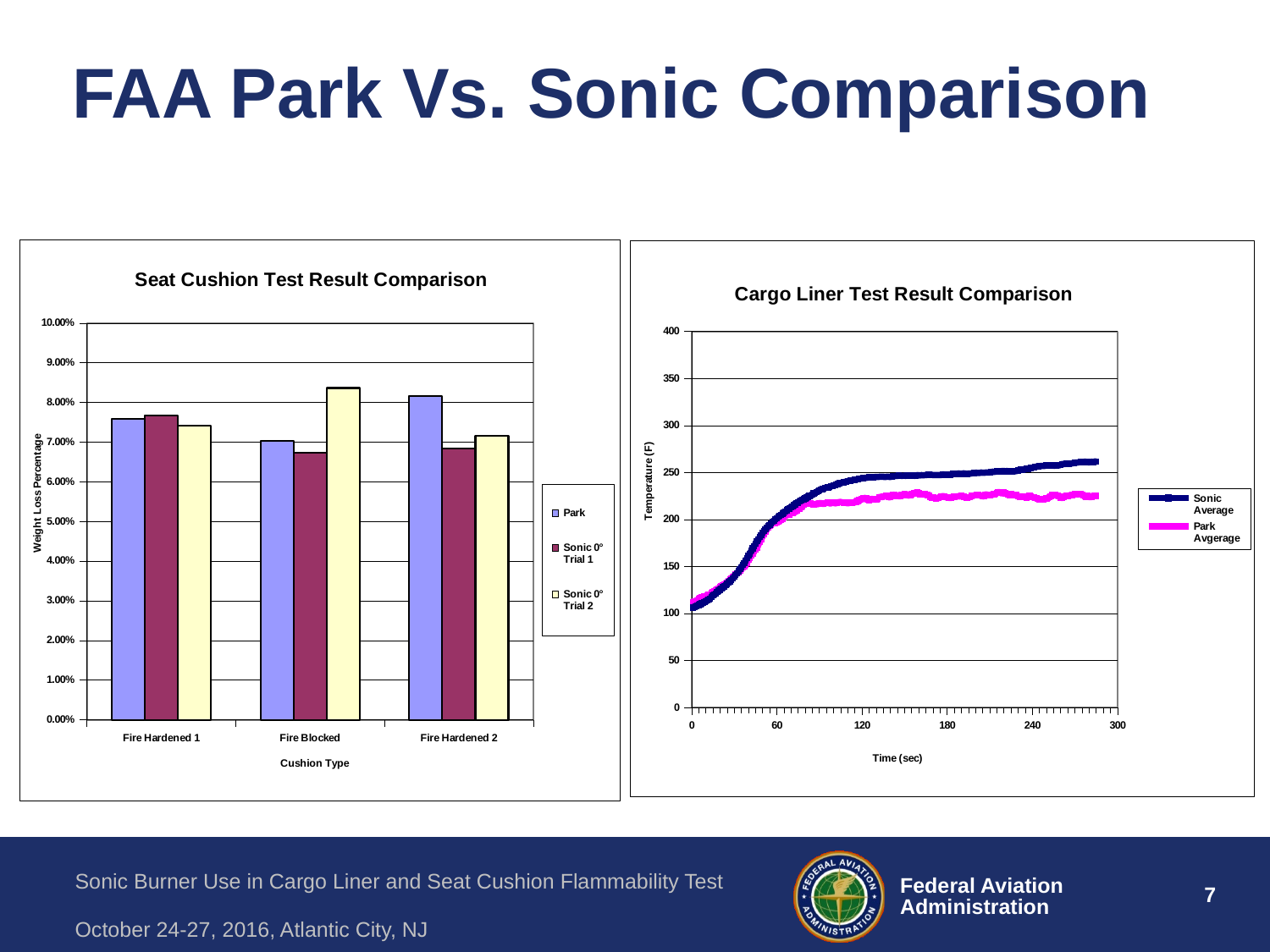
What kind of chart is the Seat Cushion Test Result Comparison chart? bar chart In the Seat Cushion Test Result Comparison chart, is the Sonic 0° Trial 2 value for Fire Blocked greater or less than 8.00%? greater In the Cargo Liner Test Result Comparison chart, do the temperatures rise or fall as time increases from 0 to 300 seconds? rise In the Seat Cushion Test Result Comparison chart, which series has the highest weight loss percentage for Fire Blocked? Sonic 0° Trial 2 How many series does the legend of the Cargo Liner Test Result Comparison chart list? 2 How many series does the legend of the Seat Cushion Test Result Comparison chart list? 3 What kind of chart is the Cargo Liner Test Result Comparison chart? line chart How many cushion types are shown on the x axis of the Seat Cushion Test Result Comparison chart? 3 In the Seat Cushion Test Result Comparison chart, is the Sonic 0° Trial 1 value for Fire Blocked greater or less than 7.00%? less In the Seat Cushion Test Result Comparison chart, for Fire Hardened 2, which is larger: the Park value or the Sonic 0° Trial 1 value? Park In the Seat Cushion Test Result Comparison chart, which series has the lowest weight loss percentage for Fire Hardened 2? Sonic 0° Trial 1